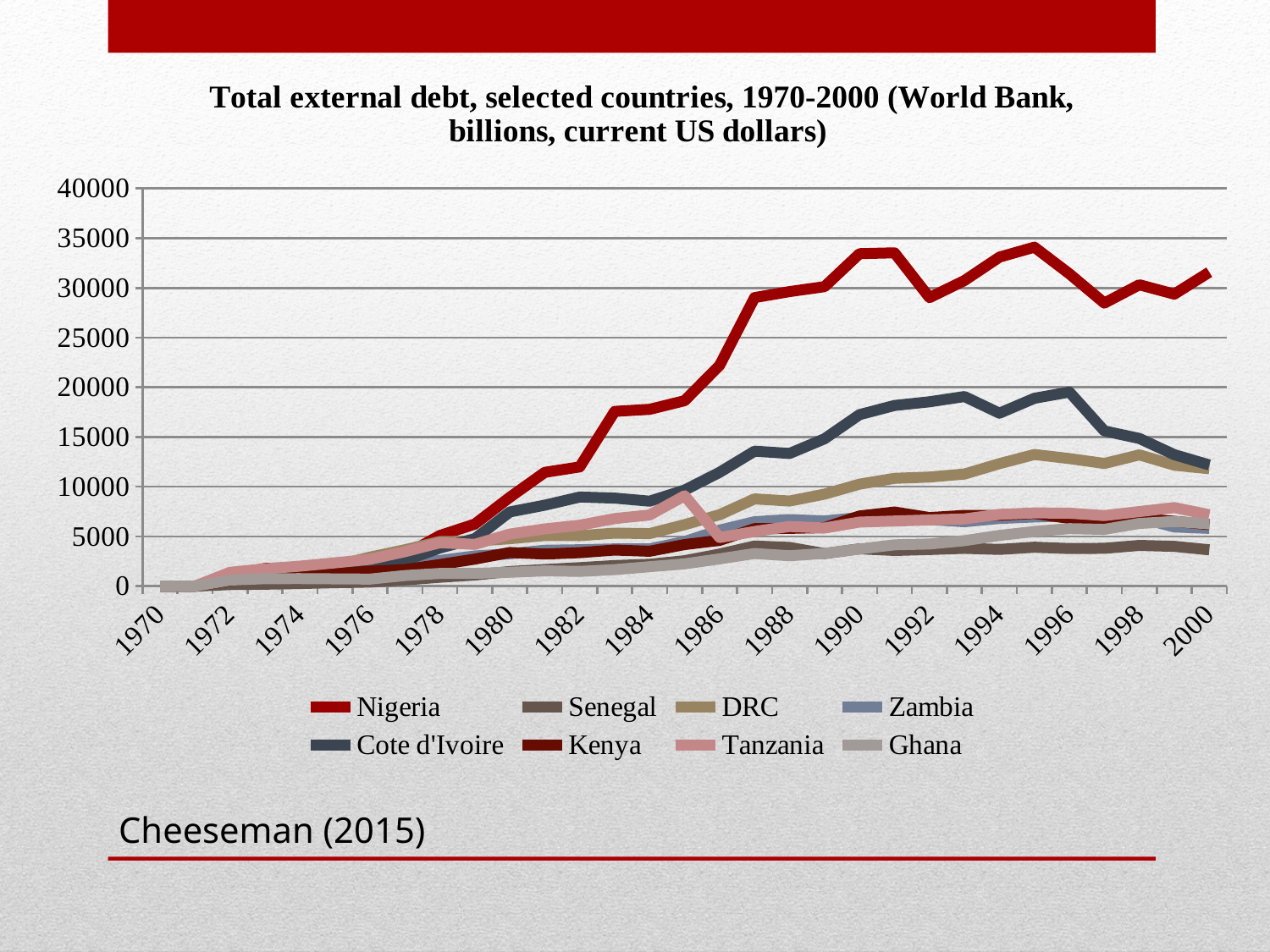
How many countries (series) does the legend list? 8 Is the value for Nigeria in 1987 greater or less than 25000? greater Is the value for Senegal in 2000 greater or less than 5000? less What is the title of the chart? Total external debt, selected countries, 1970-2000 (World Bank, billions, current US dollars) Which country has the highest total external debt in 1990? Nigeria What kind of chart is shown on the slide? line chart Is the value for Nigeria in 1990 greater or less than 30000? greater Does Nigeria's total external debt rise or fall between 1970 and 1990? rise In 1996, which has the larger total external debt, Cote d'Ivoire or DRC? Cote d'Ivoire Which country has the highest total external debt in 2000? Nigeria